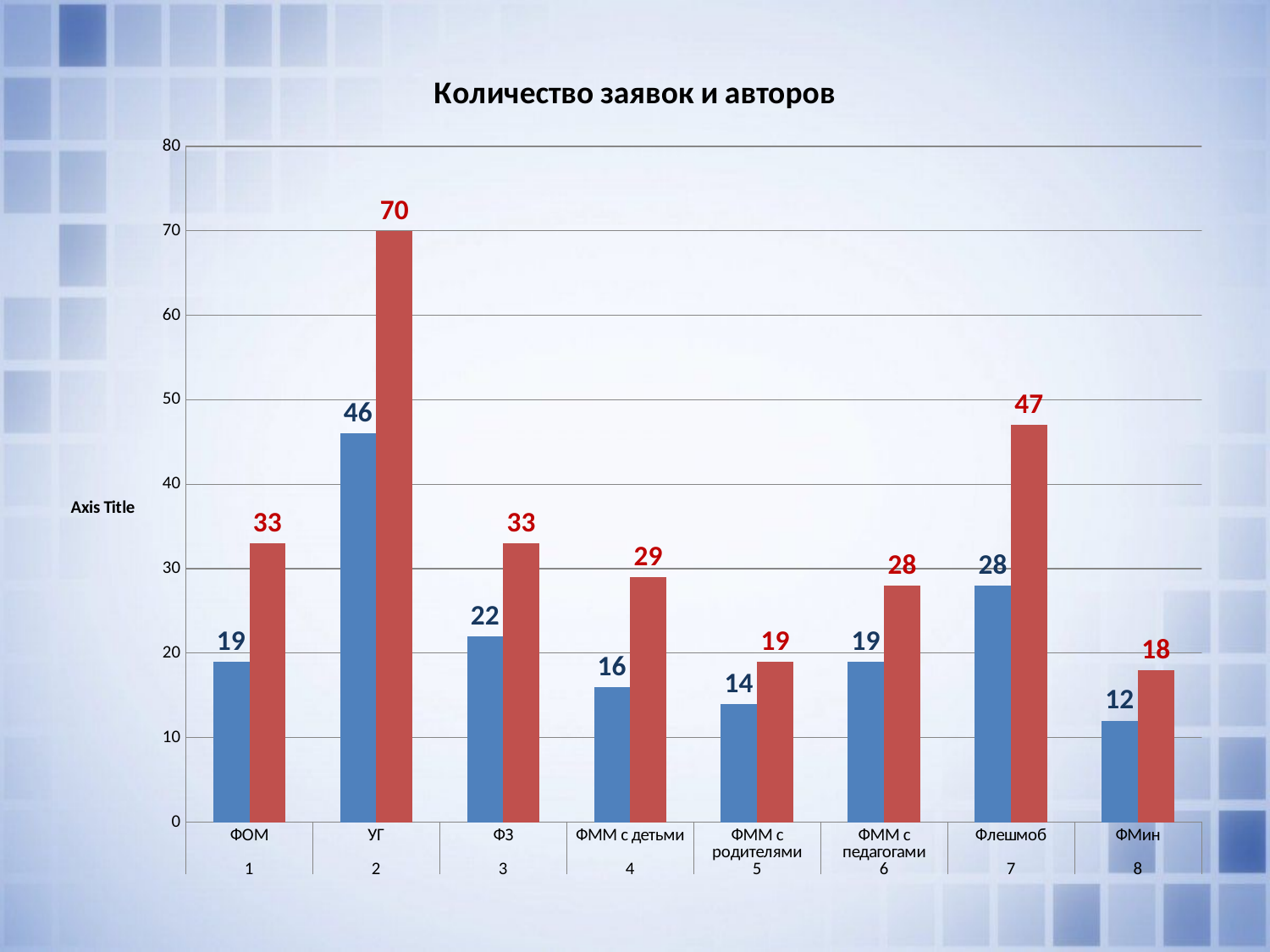
Which category has the lowest blue bar? ФМин What is the value of the blue bar for ФММ с родителями? 14 What is the difference between the red and blue bars for УГ? 24 What type of chart is shown on the slide? Bar chart What is the value of the red bar for Флешмоб? 47 What is the value of the blue bar for УГ? 46 Which category has the highest red bar? УГ What is the difference between the red bars for Флешмоб and ФОМ? 14 Which is larger: the blue bar for ФЗ or the blue bar for ФММ с детьми? ФЗ What is the title of the chart? Количество заявок и авторов What is the value of the red bar for ФМин? 18 How many categories are shown on the x axis? 8